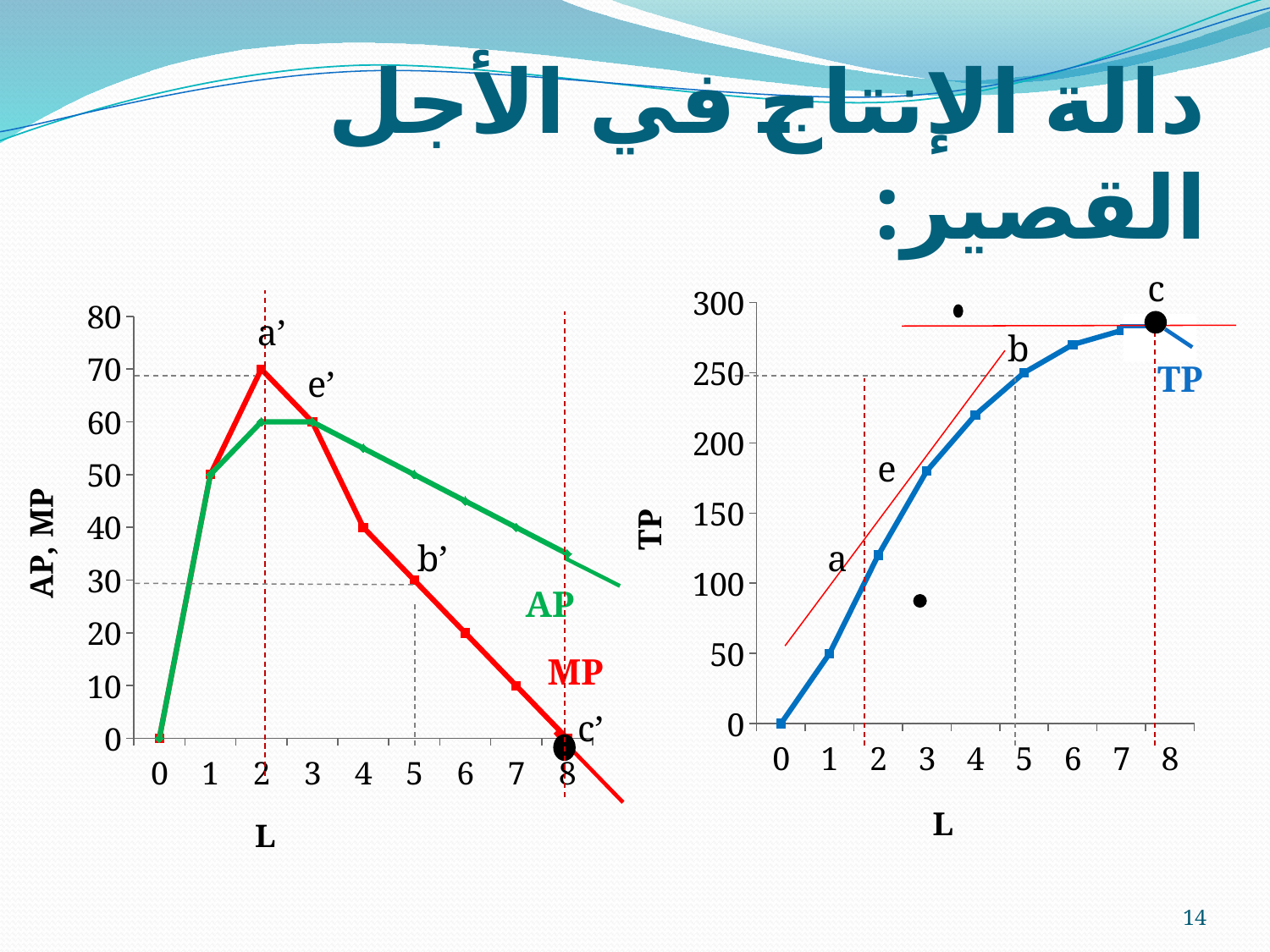
On the right chart (TP against L), is the value of TP at L = 3 greater or less than 150? greater On the left chart, at which value of L does MP reach its highest value? 2 What kind of chart is the left chart (AP, MP against L)? line chart On the left chart, what is the value of MP at L = 2? 70 On the left chart, is the value of AP at L = 8 greater or less than 40? less On the right chart (TP against L), what is the value of TP at L = 1? 50 On the left chart, what is the value of MP at L = 5? 30 How many series are plotted on the left chart (AP, MP against L)? 2 On the left chart, what is the difference between MP at L = 2 and MP at L = 5? 40 What is the label of the vertical axis on the right chart? TP On the left chart, at L = 4, which is larger, AP or MP? AP On the right chart (TP against L), does TP rise or fall as L increases from 0 to 7? rises